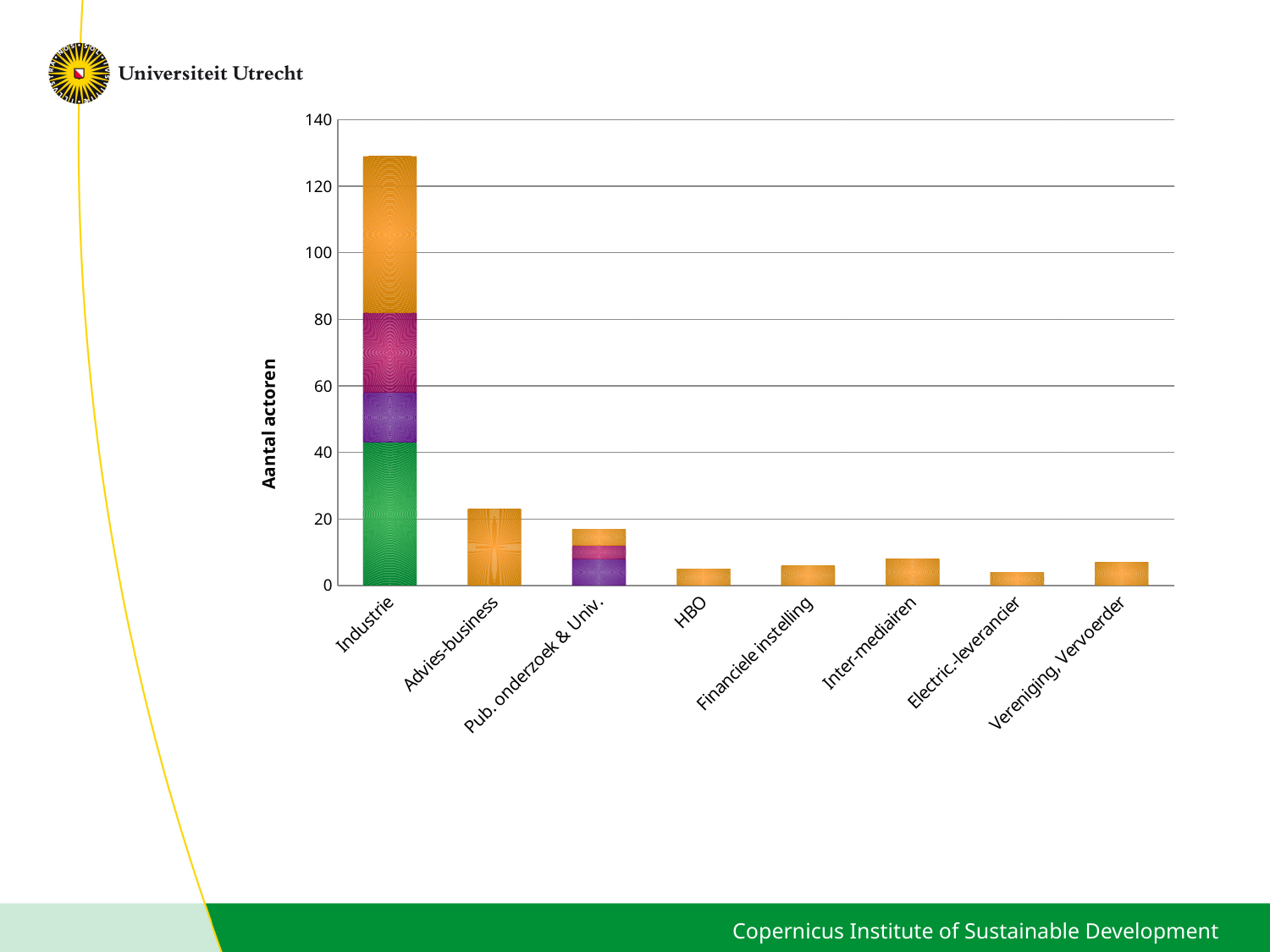
Which category has the highest total number of actors? Industrie How many categories are shown on the x axis of the chart? 8 What kind of chart is shown on the slide? Stacked bar chart Is the value for Pub. onderzoek & Univ. greater or less than 20? less Is the value for Advies-business greater or less than 20? greater Is the value for HBO greater or less than 20? less How many coloured segments make up the Industrie bar? 4 Which is larger, the value for Advies-business or the value for Pub. onderzoek & Univ.? Advies-business What is the label of the y axis? Aantal actoren Which is larger, the value for Industrie or the value for Advies-business? Industrie